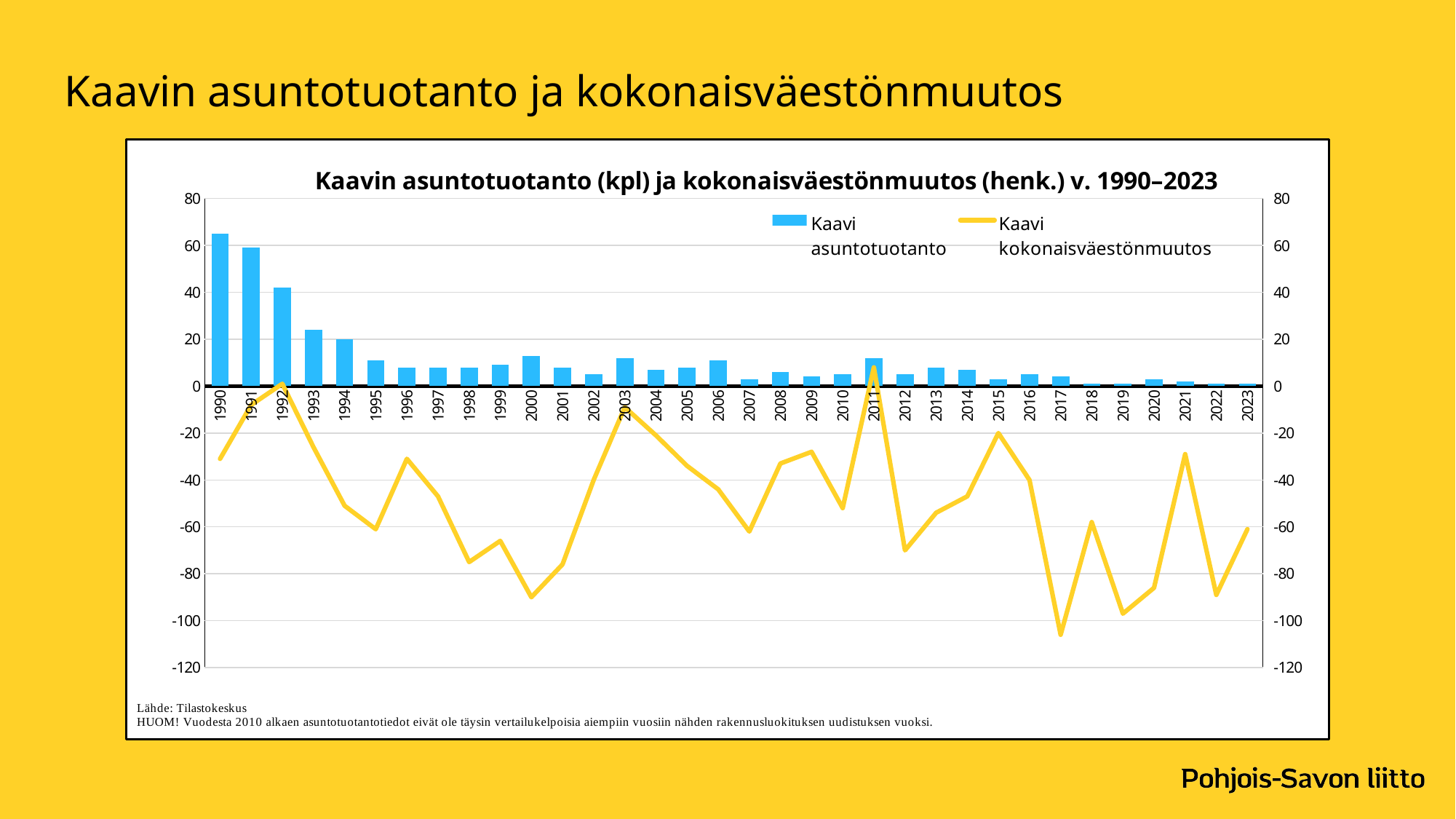
Is the Kaavi asuntotuotanto value for 1990 greater or less than 60? greater How many years are shown on the x axis? 34 In which year is the Kaavi asuntotuotanto bar the highest? 1990 Is the Kaavi kokonaisväestönmuutos value for 2000 greater or less than -80? less Is the Kaavi kokonaisväestönmuutos value for 2017 greater or less than -100? less What colour is the Kaavi kokonaisväestönmuutos line? Yellow Which year has the larger Kaavi asuntotuotanto bar, 1991 or 1992? 1991 Do the Kaavi asuntotuotanto bars rise or fall from 1990 to 1995? fall What kind of chart is shown on the slide? A combined bar and line chart How many series does the legend list? 2 In which year does the Kaavi kokonaisväestönmuutos line reach its lowest value? 2017